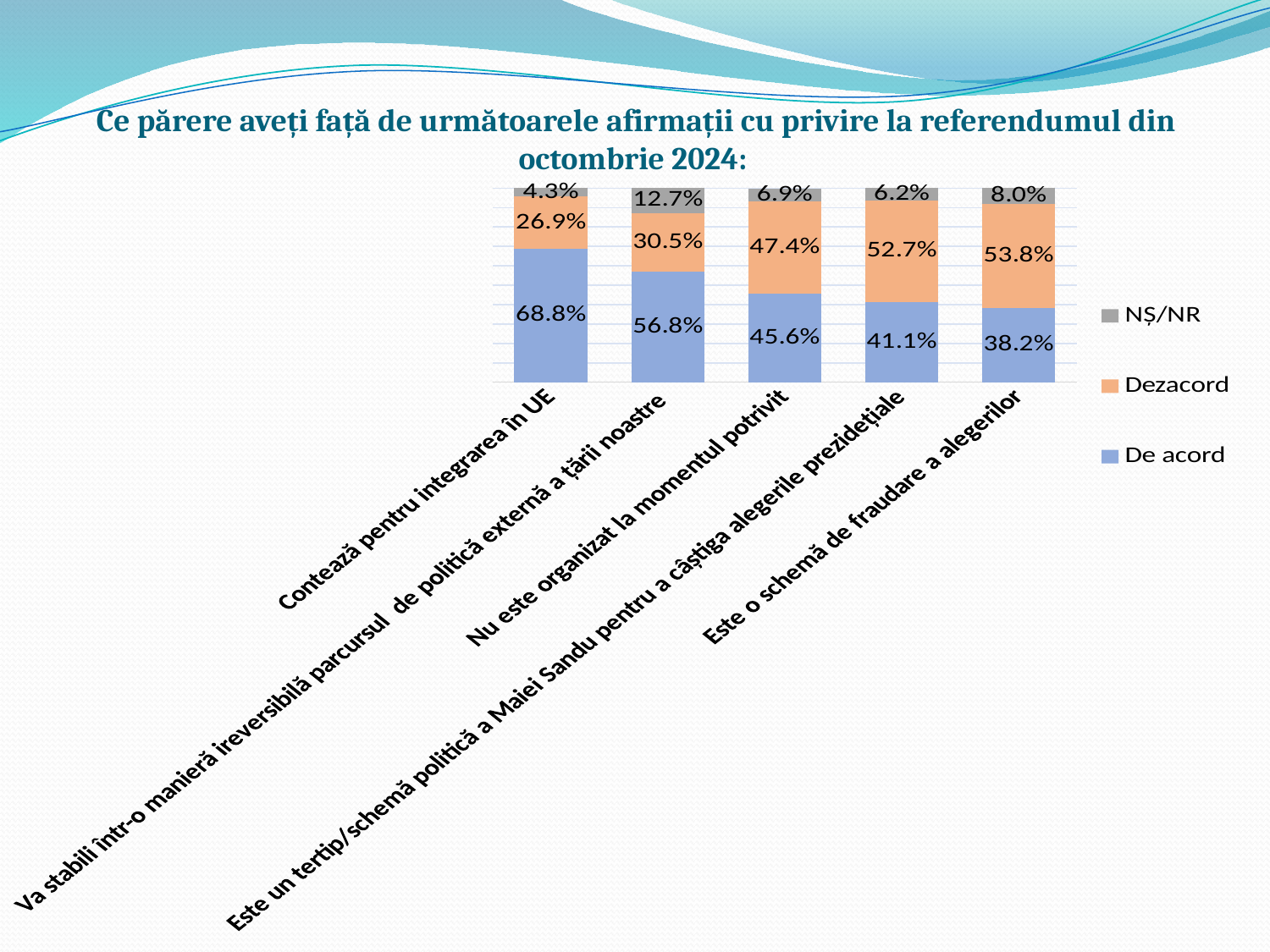
What is the difference between the "De acord" and "Dezacord" values for "Contează pentru integrarea în UE"? 41.9% What kind of chart is shown on the slide? Stacked bar chart Which statement has the highest "NȘ/NR" share? Va stabili într-o manieră ireversibilă parcursul de politică externă a țării noastre Which statement has the highest "De acord" share? Contează pentru integrarea în UE Which statement has the lowest "De acord" share? Este o schemă de fraudare a alegerilor What is the "Dezacord" value for "Este o schemă de fraudare a alegerilor"? 53.8% What is the total of the stacked bar for "Este un tertip/schemă politică a Maiei Sandu pentru a câștiga alegerile prezidețiale"? 100.0% How many series does the legend list? 3 What percentage of respondents answered "De acord" for "Contează pentru integrarea în UE"? 68.8% How many statements (categories) are shown in the chart? 5 What is the "NȘ/NR" value for "Va stabili într-o manieră ireversibilă parcursul de politică externă a țării noastre"? 12.7% For "Nu este organizat la momentul potrivit", which is larger: "De acord" or "Dezacord"? Dezacord